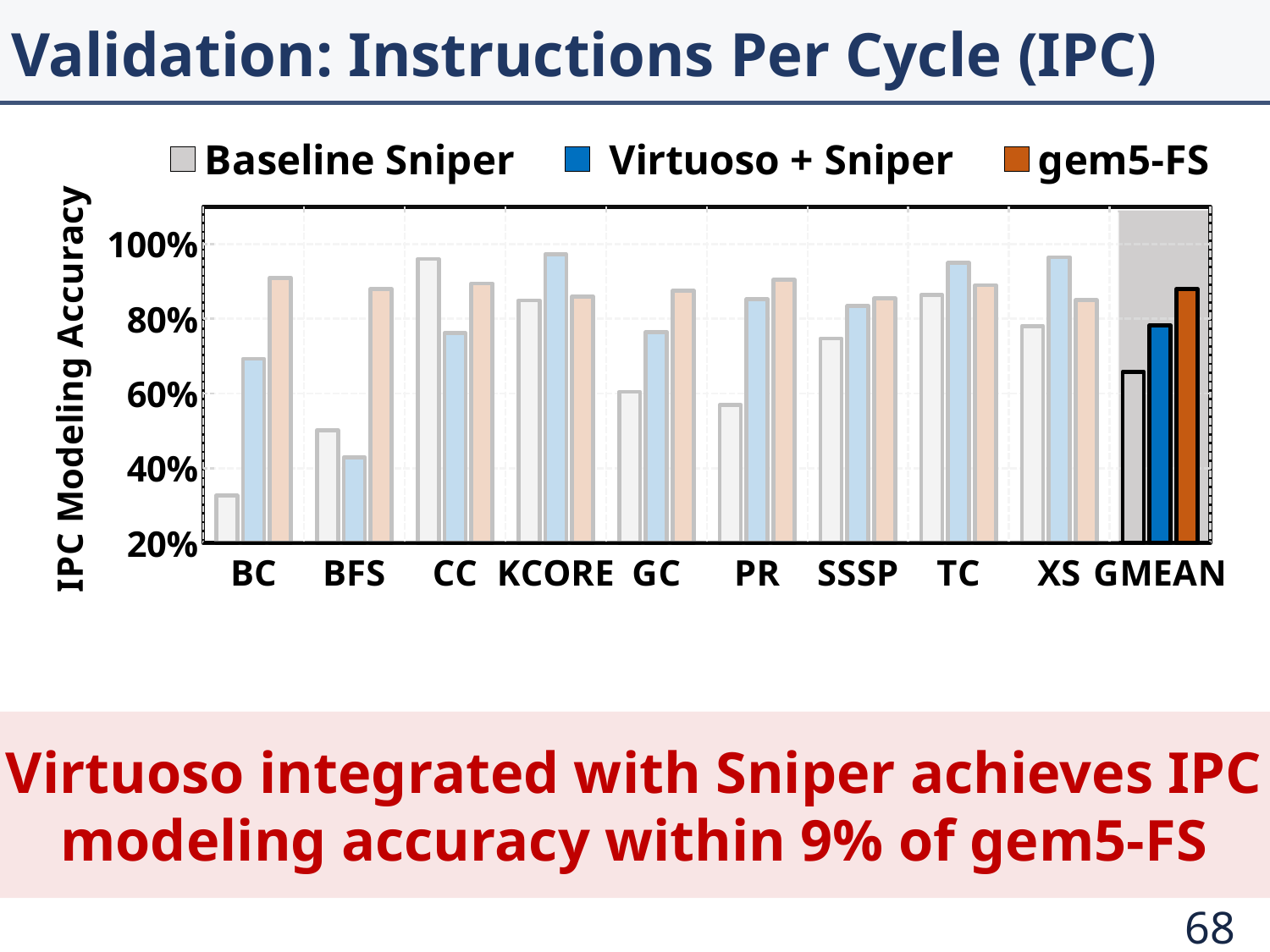
What is the label of the y axis? IPC Modeling Accuracy For CC, which is larger: the Baseline Sniper value or the Virtuoso + Sniper value? Baseline Sniper Is the gem5-FS value for BC greater or less than 80%? greater Which category has the lowest Baseline Sniper value? BC What kind of chart is shown on the slide? bar chart Is the Baseline Sniper value for SSSP greater or less than 80%? less Which series is shown in dark blue in the legend? Virtuoso + Sniper How many series does the legend list? 3 Is the Virtuoso + Sniper value for BFS greater or less than 60%? less How many categories are shown on the x axis? 10